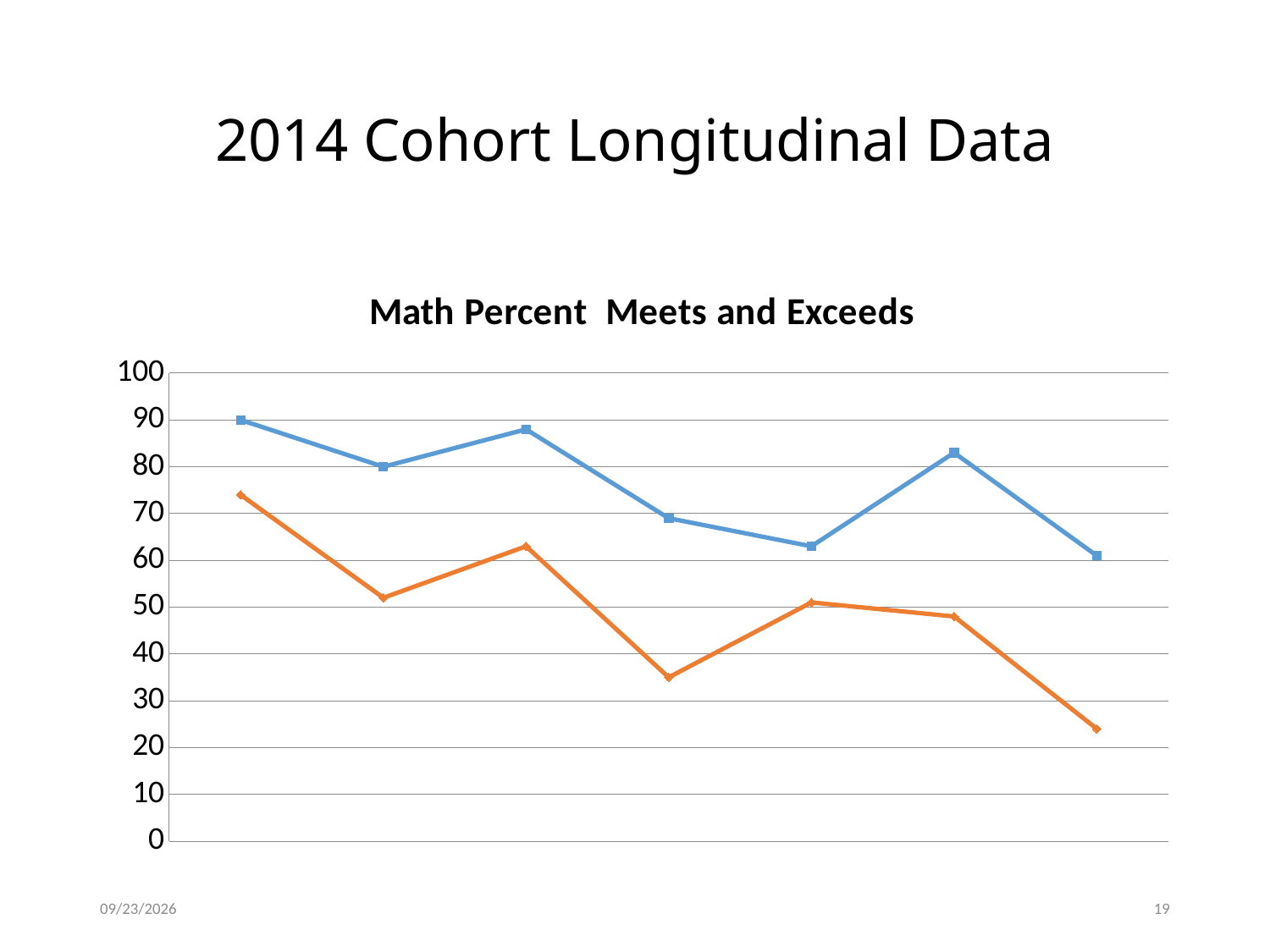
At the first point, which line has the higher value, the blue line or the orange line? the blue line How many data points does the blue line have? 7 Is the value of the last point on the blue line greater or less than 70? less What kind of chart is shown on the slide? line chart What is the value of the first point on the blue line? 90 Which point on the orange line has the lowest value? the last point How many lines are plotted on the chart? 2 Is the value of the last point on the orange line greater or less than 30? less Is the value of the first point on the orange line greater or less than 70? greater Do the values on the orange line generally rise or fall from left to right? fall What is the title of the chart? Math Percent Meets and Exceeds What is the value of the second point on the blue line? 80